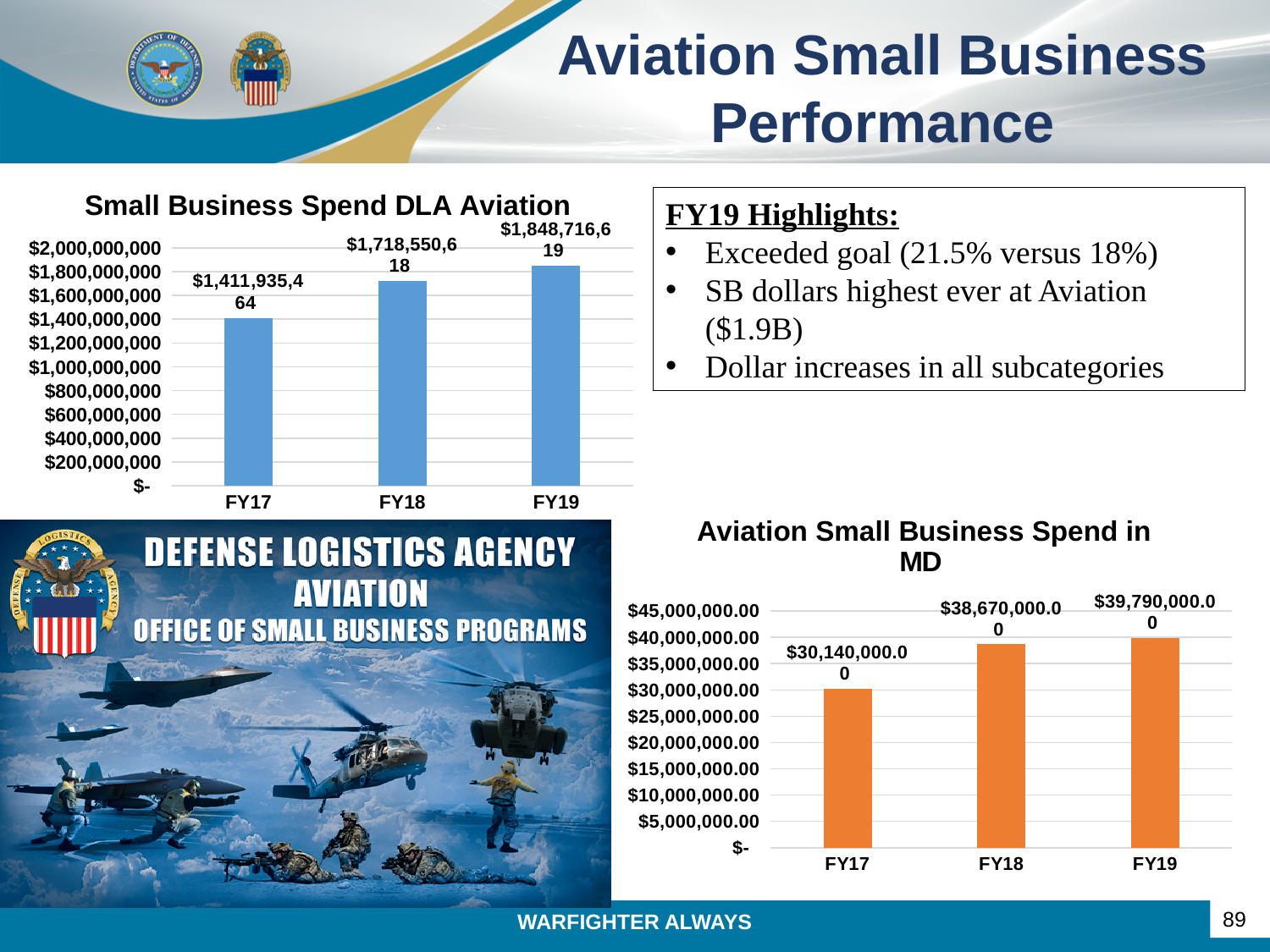
In the 'Small Business Spend DLA Aviation' chart, what is the value for FY17? $1,411,935,464 In the 'Small Business Spend DLA Aviation' chart, which fiscal year has the lowest spend? FY17 In the 'Aviation Small Business Spend in MD' chart, what is the value for FY18? $38,670,000.00 In the 'Small Business Spend DLA Aviation' chart, what is the value for FY19? $1,848,716,619 In the 'Aviation Small Business Spend in MD' chart, which fiscal year has the highest spend? FY19 In the 'Aviation Small Business Spend in MD' chart, is the value for FY17 greater or less than $35,000,000.00? less In the 'Small Business Spend DLA Aviation' chart, do the values rise or fall from FY17 to FY19? rise In the 'Aviation Small Business Spend in MD' chart, what is the difference between the FY19 and FY18 values? $1,120,000.00 In the 'Small Business Spend DLA Aviation' chart, how many fiscal years are plotted? 3 What type of chart is the 'Aviation Small Business Spend in MD' chart? bar chart In the 'Small Business Spend DLA Aviation' chart, what is the difference between the FY18 and FY17 values? $306,615,154 What colour are the bars in the 'Aviation Small Business Spend in MD' chart? orange